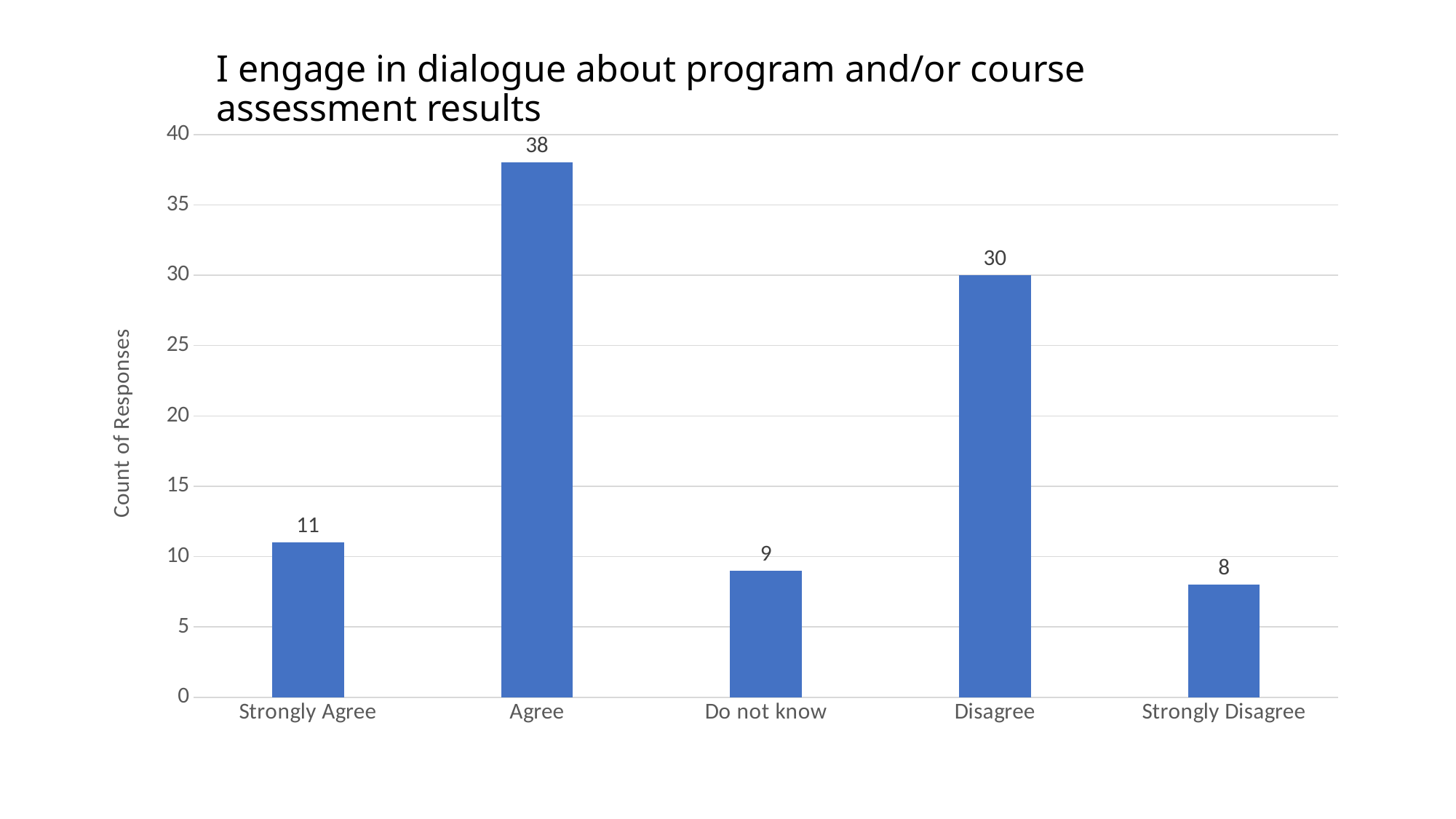
What is the difference between the counts for Agree and Disagree? 8 Is the value for Disagree greater or less than 25? greater What is the difference between the counts for Strongly Agree and Strongly Disagree? 3 What is the count of responses for Agree? 38 What is the label of the vertical axis? Count of Responses What is the count of responses for Do not know? 9 Which has a higher count of responses, Strongly Agree or Do not know? Strongly Agree What kind of chart is shown on the slide? Bar chart Which category has the highest count of responses? Agree How many categories are shown on the x axis? 5 What is the count of responses for Strongly Disagree? 8 Which category has the lowest count of responses? Strongly Disagree